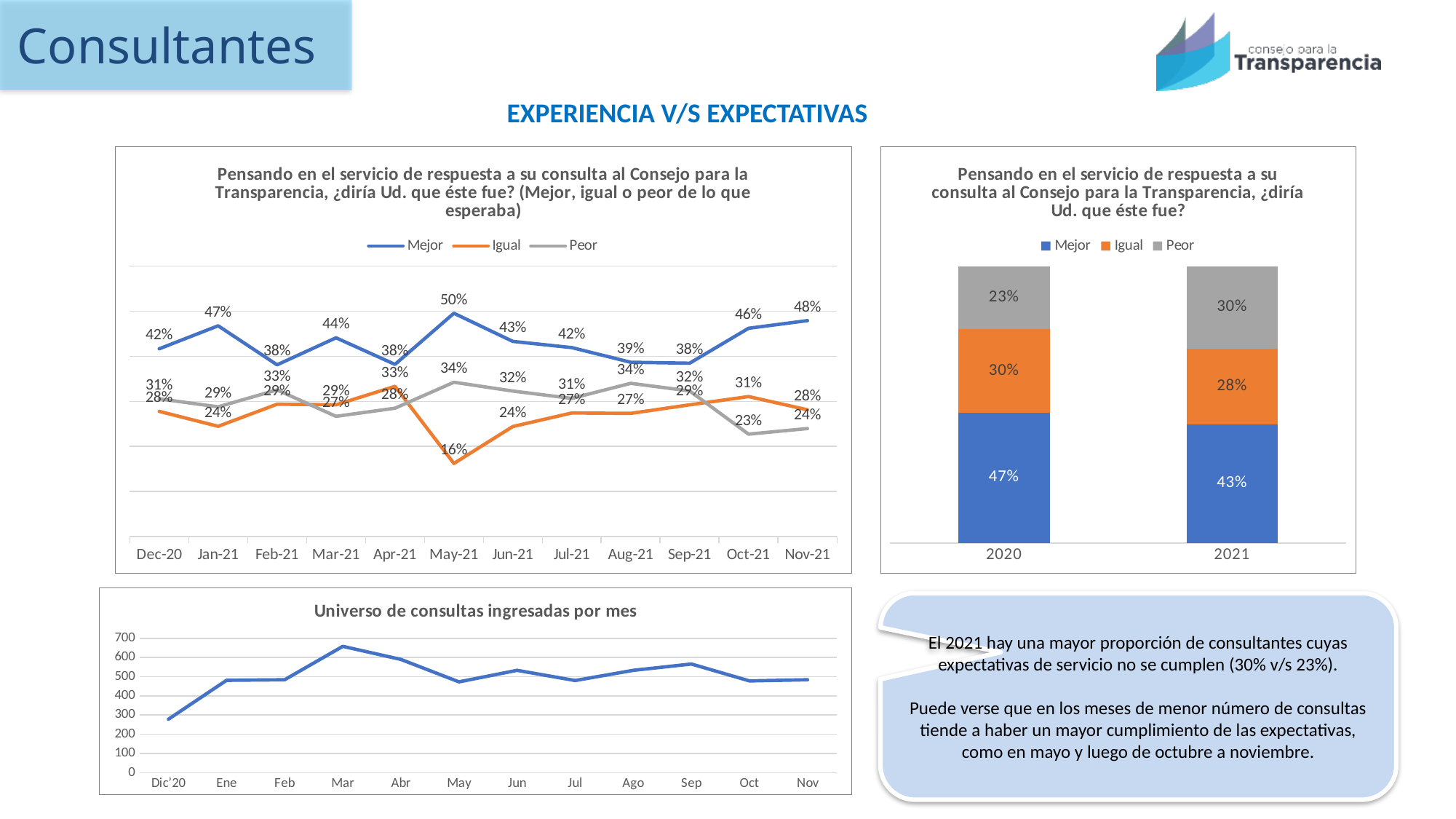
In the top-right stacked bar chart, what is the total of the 2020 bar? 100% In the chart 'Universo de consultas ingresadas por mes', is the value for Mar greater or less than 600? greater In the top-left line chart, what is the value for Mejor in May-21? 50% What kind of chart is 'Universo de consultas ingresadas por mes'? Line chart In the top-right stacked bar chart, what is the Peor share for 2021? 30% In the top-left line chart, in which month is the Igual series lowest? May-21 In the top-left line chart, in which month is the Mejor series highest? May-21 In the chart 'Universo de consultas ingresadas por mes', which month has the highest value? Mar In the top-left line chart, what is the value for Igual in May-21? 16% In the top-right stacked bar chart, which year has the larger Mejor value, 2020 or 2021? 2020 In the top-left line chart, what is the difference between the Mejor values for Nov-21 and Dec-20? 6% How many series does the legend of the top-left line chart list? 3